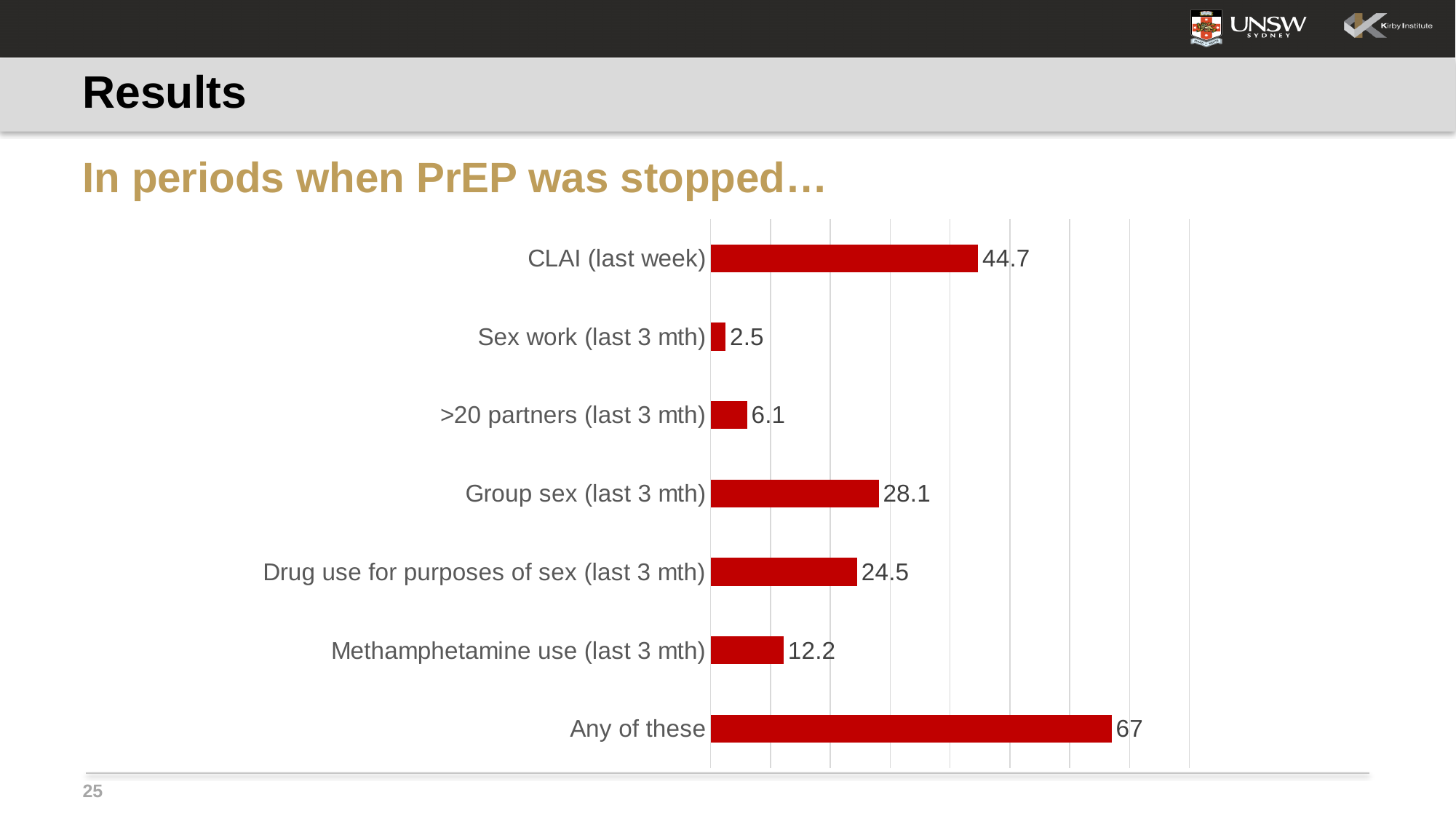
What is the value for Any of these? 67 Which category has the highest value? Any of these Which category has the lowest value? Sex work (last 3 mth) What is the difference between the values for Group sex (last 3 mth) and Drug use for purposes of sex (last 3 mth)? 3.6 How many categories are shown in the chart? 7 What is the value for Methamphetamine use (last 3 mth)? 12.2 What colour are the bars in the chart? Red Which is larger, the value for >20 partners (last 3 mth) or the value for Sex work (last 3 mth)? >20 partners (last 3 mth) What is the difference between the values for Any of these and CLAI (last week)? 22.3 What is the value for Group sex (last 3 mth)? 28.1 What is the value for CLAI (last week)? 44.7 What kind of chart is shown on the slide? Bar chart